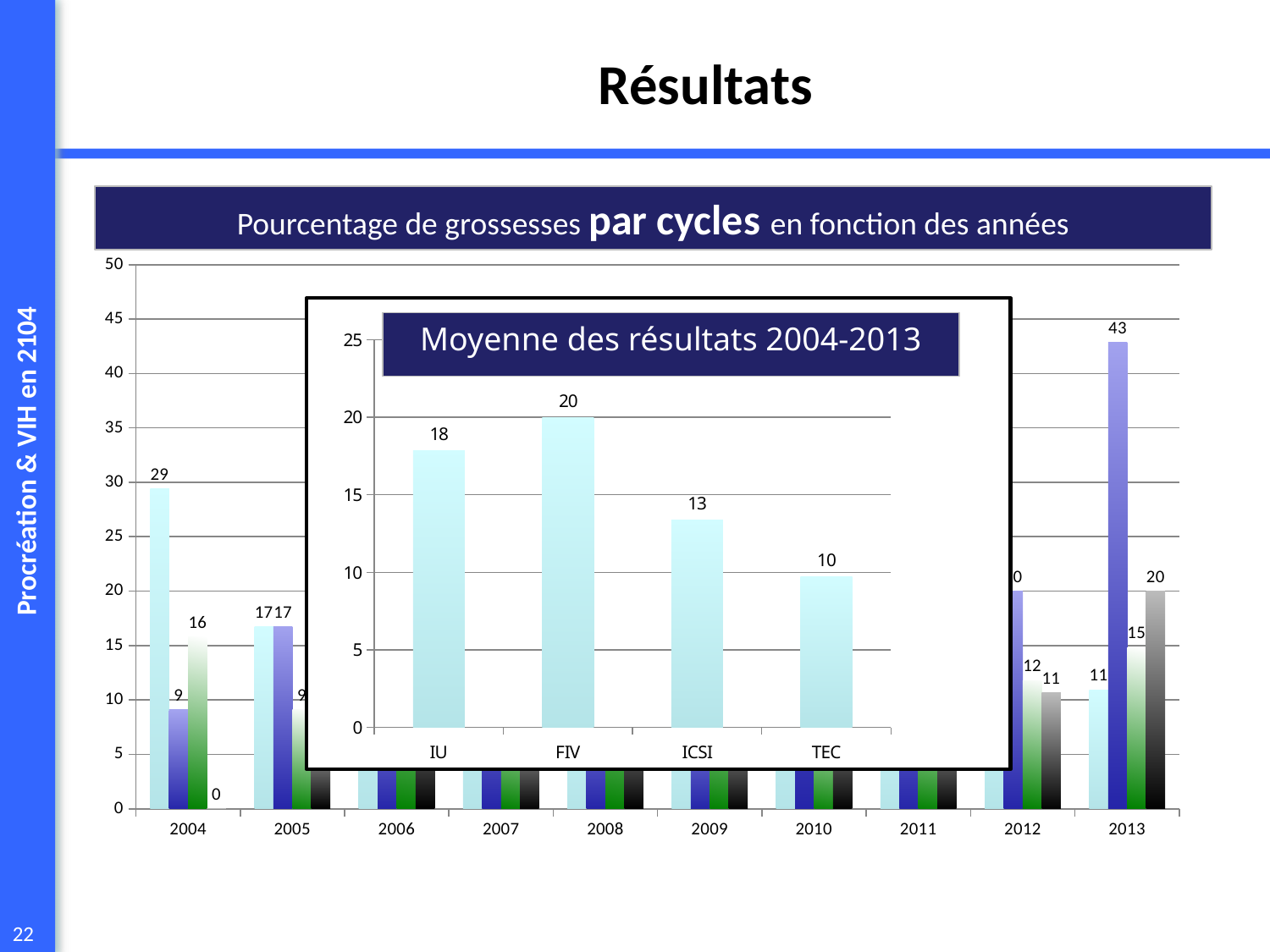
In the main chart 'Pourcentage de grossesses par cycles en fonction des années', what is the highest labelled value for 2013? 43 In the inset chart 'Moyenne des résultats 2004-2013', what is the value for FIV? 20 In the inset chart 'Moyenne des résultats 2004-2013', which category has the lowest value? TEC In the inset chart 'Moyenne des résultats 2004-2013', which category has the highest value? FIV In the main chart 'Pourcentage de grossesses par cycles en fonction des années', what is the value of the light blue bar for 2004? 29 In the main chart 'Pourcentage de grossesses par cycles en fonction des années', how many years are shown on the x axis? 10 In the inset chart 'Moyenne des résultats 2004-2013', what is the value for IU? 18 In the inset chart 'Moyenne des résultats 2004-2013', what is the difference between the values for FIV and ICSI? 7 In the inset chart 'Moyenne des résultats 2004-2013', what is the value for TEC? 10 What kind of chart is the main chart 'Pourcentage de grossesses par cycles en fonction des années'? bar chart In the inset chart 'Moyenne des résultats 2004-2013', how many categories are shown on the x axis? 4 In the inset chart 'Moyenne des résultats 2004-2013', is the value for ICSI greater or less than 15? less